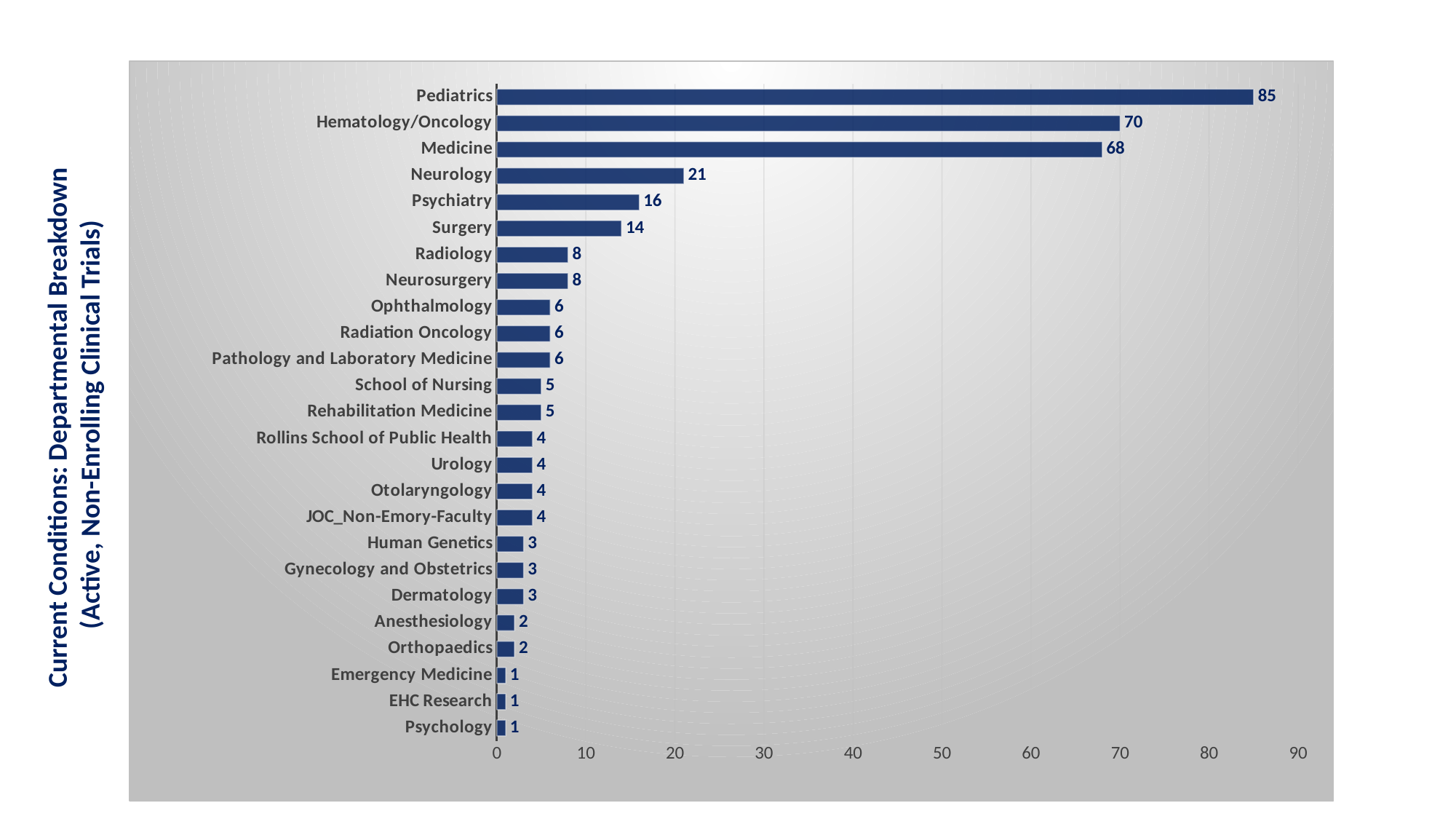
What is the difference between the values for Pediatrics and Neurology? 64 Is the value for Medicine greater or less than 60? greater What is the value for Anesthesiology? 2 Which department has the highest value? Pediatrics Which is larger, the value for Psychiatry or the value for Surgery? Psychiatry What is the value for Pediatrics? 85 What kind of chart is shown on the slide? Bar chart What is the value for Pathology and Laboratory Medicine? 6 How many departments are shown in the chart? 25 What is the value for Neurology? 21 What is the difference between the values for Hematology/Oncology and Medicine? 2 What is the title of the chart? Current Conditions: Departmental Breakdown (Active, Non-Enrolling Clinical Trials)